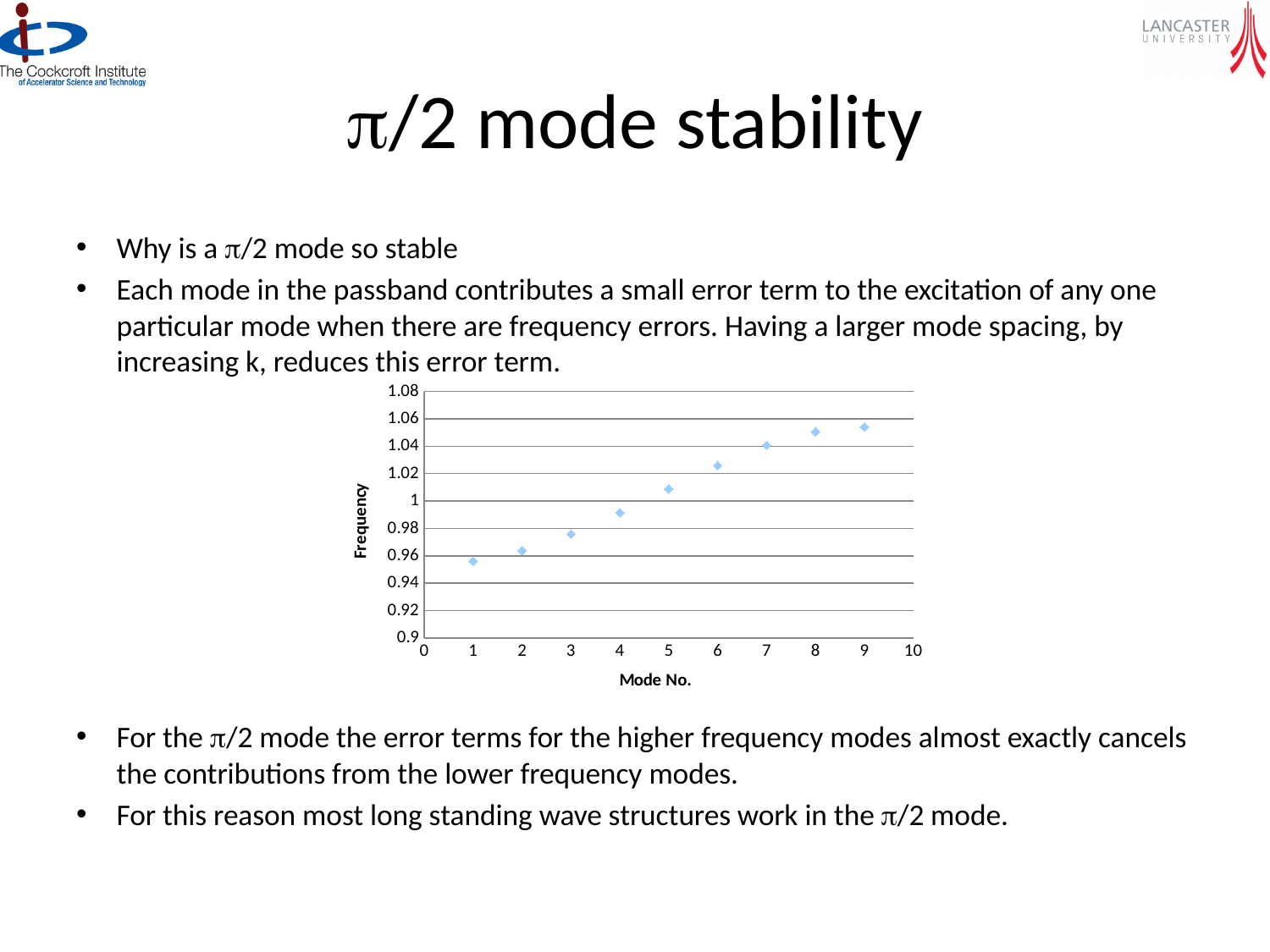
Which mode number has the highest frequency? 9 Which has the larger frequency, mode 3 or mode 7? mode 7 Is the frequency for mode 7 greater or less than 1.02? greater What kind of chart is shown on the slide? scatter chart How many data points are plotted in the chart? 9 Which mode number has the lowest frequency? 1 Is the frequency for mode 1 greater or less than 0.98? less What is the label on the vertical axis of the chart? Frequency Is the frequency for mode 9 greater or less than 1.06? less Do the frequency values rise or fall as the mode number increases? rise